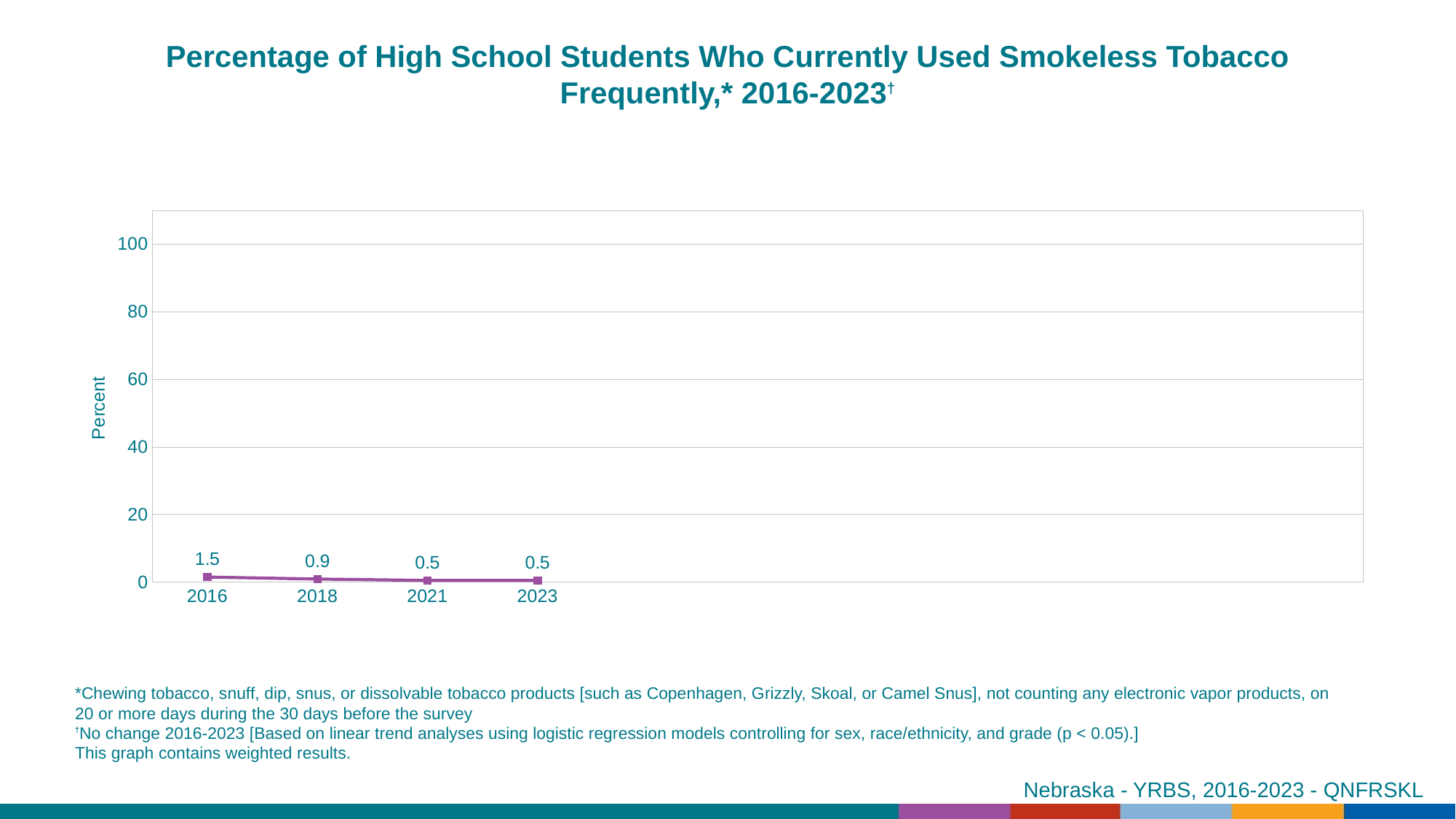
What is the difference between the values for 2016 and 2018? 0.6 What is the value for 2016? 1.5 What is the value for 2021? 0.5 Do the values rise or fall from 2016 to 2021? fall How many years are plotted on the chart? 4 What is the difference between the values for 2016 and 2023? 1.0 Which is larger, the value for 2016 or the value for 2018? 2016 Is the value for 2016 greater or less than 20? less What is the value for 2023? 0.5 What kind of chart is shown on the slide? line chart Which year has the highest value? 2016 What is the value for 2018? 0.9